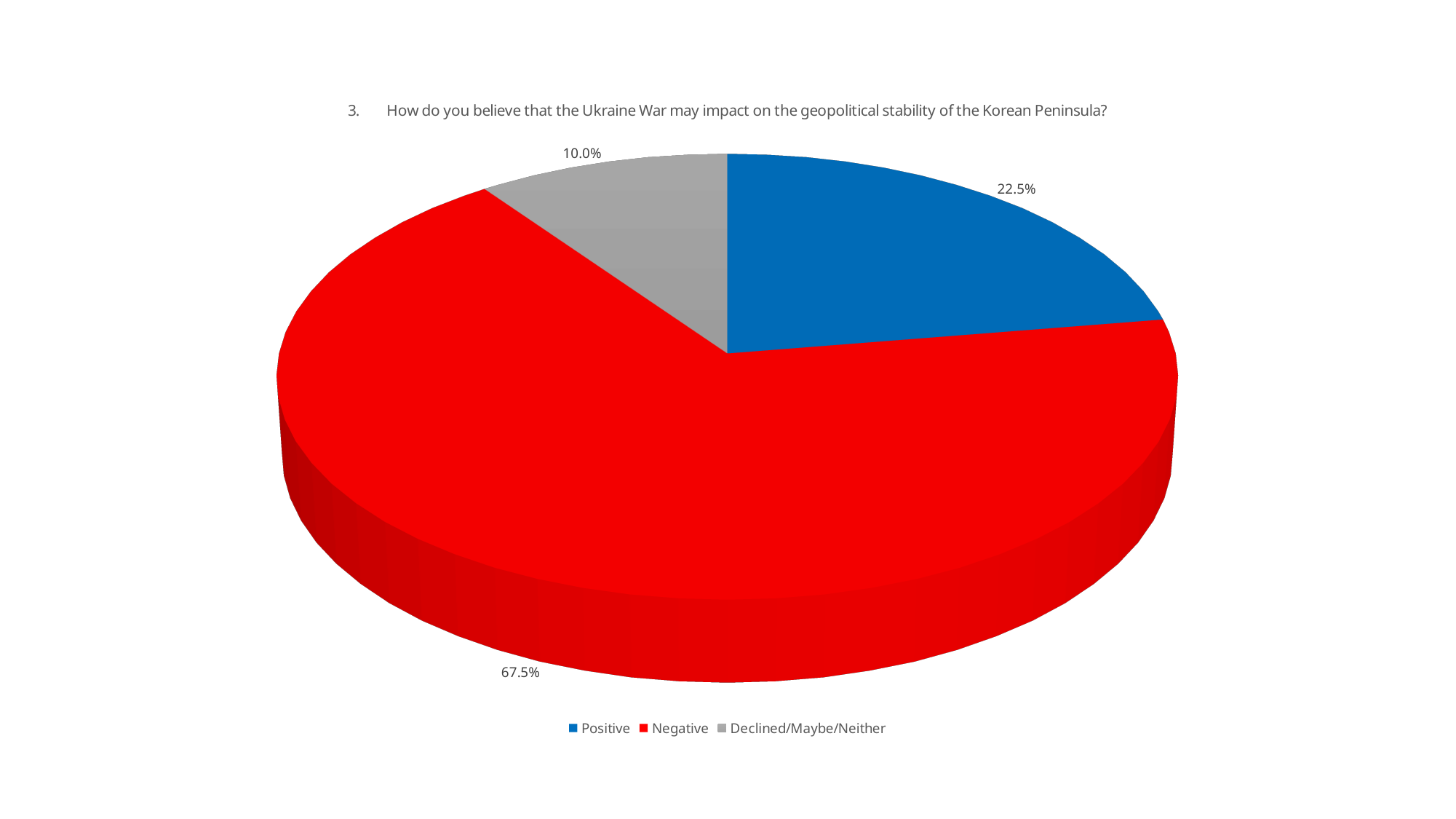
What share of the pie is labelled Negative? 67.5% What colour is the Negative slice? Red What share of the pie is labelled Declined/Maybe/Neither? 10.0% What kind of chart is shown on the slide? Pie chart What share of the pie is labelled Positive? 22.5% What is the difference in percentage points between the Negative and Positive slices? 45.0% Which category has the smallest slice of the pie? Declined/Maybe/Neither Which category has the largest slice of the pie? Negative What is the difference in percentage points between the Positive and Declined/Maybe/Neither slices? 12.5% How many categories does the pie chart show? 3 Which slice is larger, Positive or Declined/Maybe/Neither? Positive What is the title of the chart? How do you believe that the Ukraine War may impact on the geopolitical stability of the Korean Peninsula?